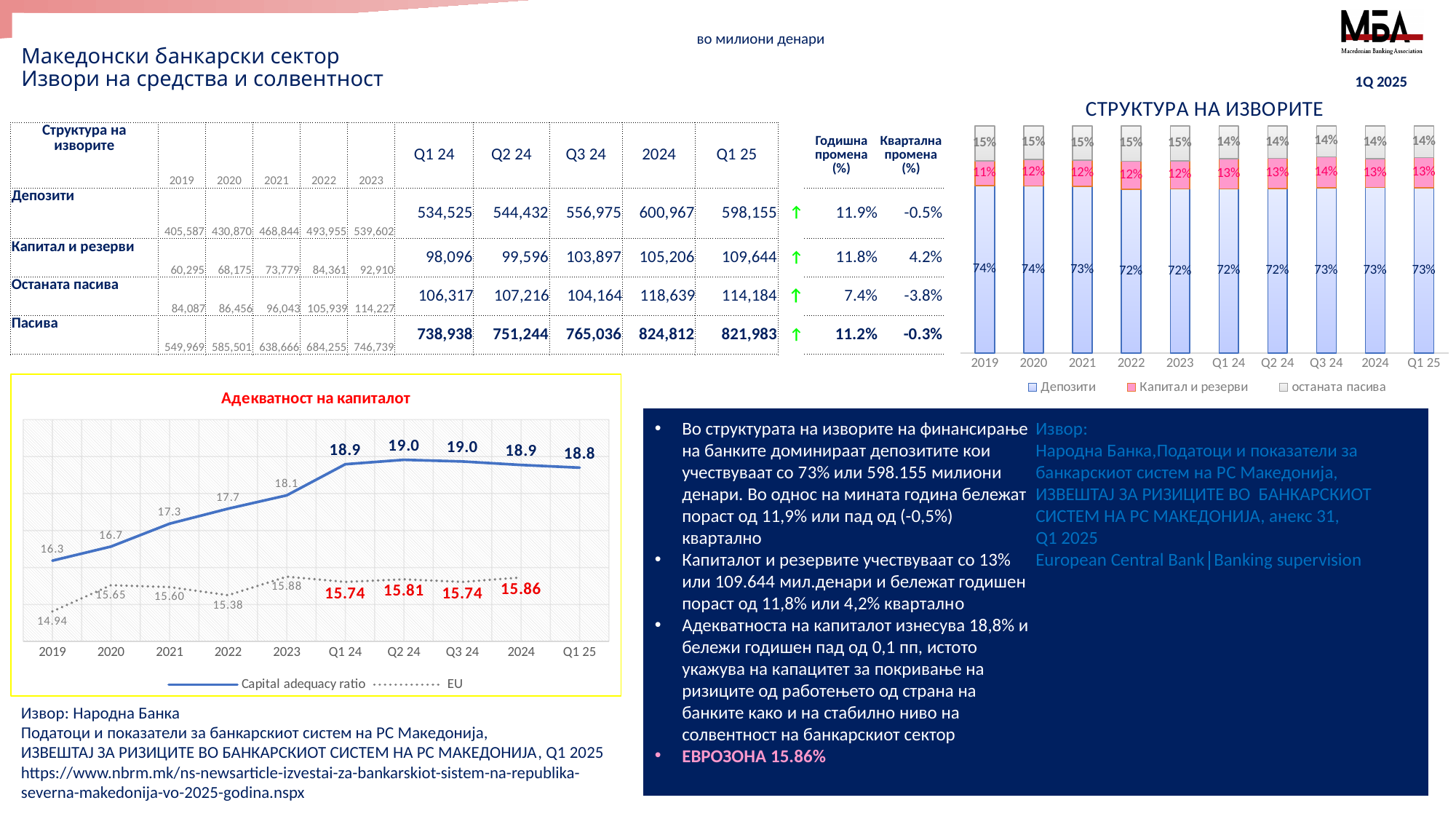
In the "Адекватност на капиталот" chart, what is the EU value for 2019? 14.94 What kind of chart is the "СТРУКТУРА НА ИЗВОРИТЕ" chart? Stacked bar chart How many series does the legend of the "СТРУКТУРА НА ИЗВОРИТЕ" chart list? 3 In the "СТРУКТУРА НА ИЗВОРИТЕ" chart, what is the share of Депозити in 2019? 74% In the "Адекватност на капиталот" chart, does the Capital adequacy ratio rise or fall from 2019 to 2023? Rise What kind of chart is the "Адекватност на капиталот" chart? Line chart In the "Адекватност на капиталот" chart, what is the Capital adequacy ratio for Q1 25? 18.8 In the "Адекватност на капиталот" chart, what is the difference between the Capital adequacy ratio in Q1 25 and in 2019? 2.5 How many periods are shown on the x axis of the "СТРУКТУРА НА ИЗВОРИТЕ" chart? 10 In the "СТРУКТУРА НА ИЗВОРИТЕ" chart, what is the share of Капитал и резерви in Q3 24? 14% In the "СТРУКТУРА НА ИЗВОРИТЕ" chart, in which period is the share of Капитал и резерви the highest? Q3 24 In the "Адекватност на капиталот" chart, in which period is the Capital adequacy ratio the lowest? 2019